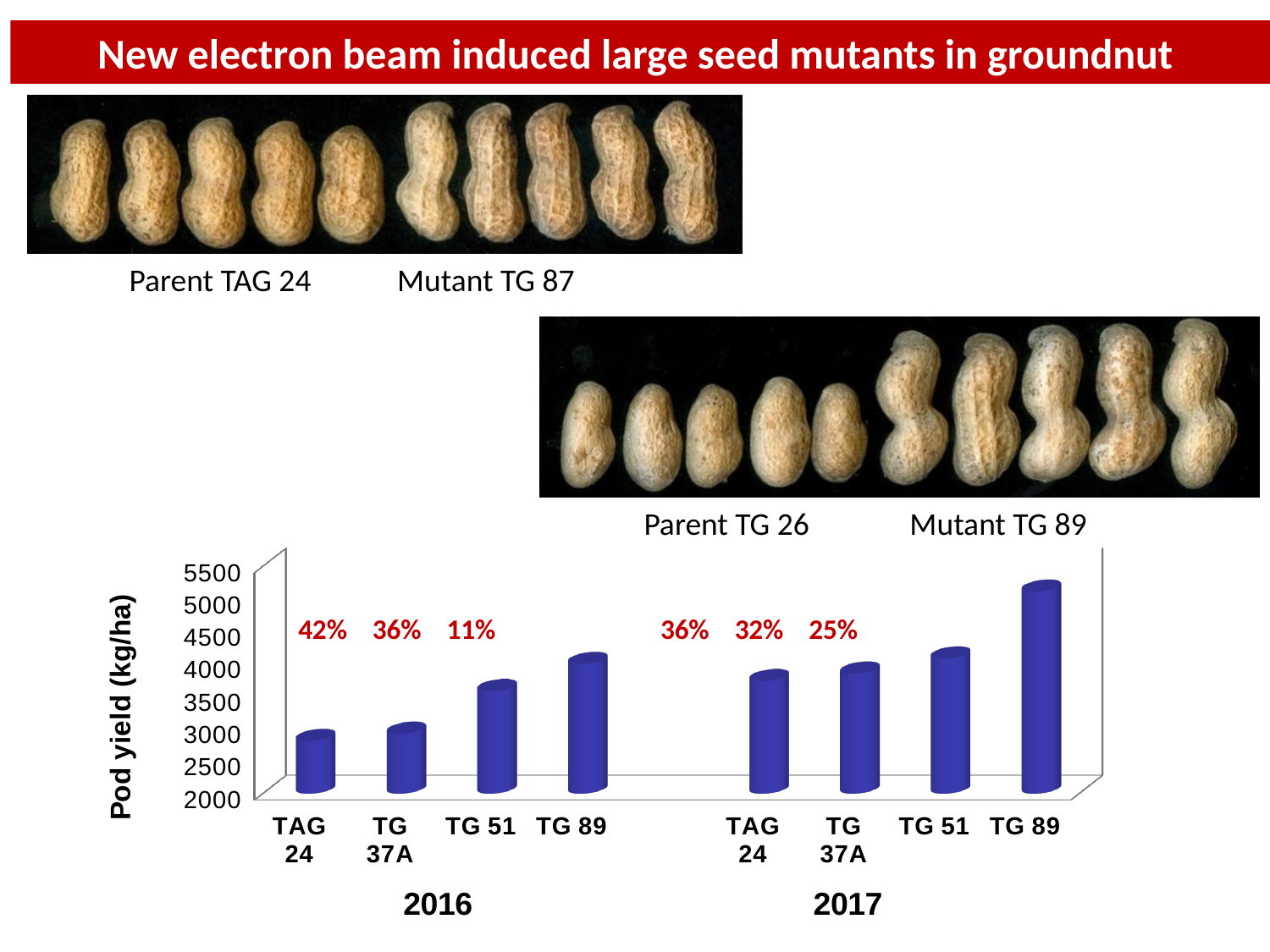
Which bar has the highest pod yield in the chart? TG 89 (2017) Within the 2016 group, do the pod yields rise or fall from TAG 24 to TG 89? rise Is the pod yield for TG 51 in 2016 greater or less than 3500 kg/ha? greater Is the pod yield for TAG 24 in 2017 greater or less than 4000 kg/ha? less Which bar has the lowest pod yield in the chart? TAG 24 (2016) What percentage label is printed above the TAG 24 bar for 2016? 42% What is the label of the y-axis in the chart? Pod yield (kg/ha) How many bars are plotted in the pod yield chart? 8 What kind of chart is shown on the slide? bar chart Is the pod yield for TG 89 in 2017 greater or less than 5000 kg/ha? greater Which has the larger pod yield: TG 89 in 2016 or TG 89 in 2017? TG 89 in 2017